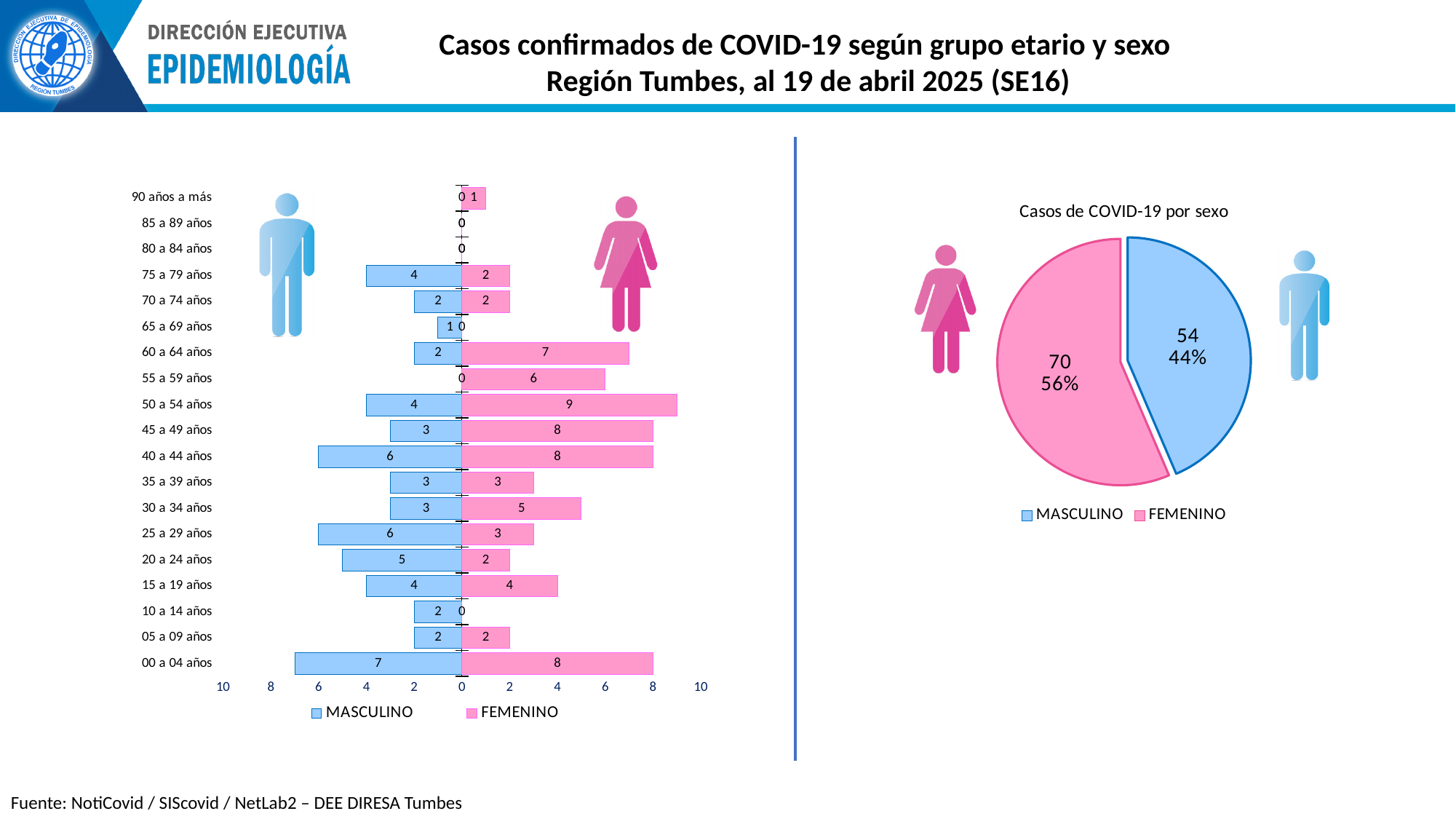
In the 'Casos de COVID-19 por sexo' pie chart, what percentage share does FEMENINO have? 56% In the left chart (age pyramid), which is larger in the 25 a 29 años group, MASCULINO or FEMENINO? MASCULINO In the left chart (age pyramid), how many series does the legend list? 2 In the left chart (age pyramid), what is the difference between FEMENINO and MASCULINO cases in the 60 a 64 años group? 5 In the left chart (age pyramid), which age group has the highest number of MASCULINO cases? 00 a 04 años What type of chart is the 'Casos de COVID-19 por sexo' chart on the right? Pie chart In the left chart (age pyramid), how many age groups are shown on the vertical axis? 19 In the left chart (age pyramid), which age group has the highest number of FEMENINO cases? 50 a 54 años In the left chart (age pyramid), how many FEMENINO cases are in the 50 a 54 años group? 9 In the 'Casos de COVID-19 por sexo' pie chart, what is the total number of cases across both slices? 124 In the left chart (age pyramid), how many FEMENINO cases are in the 60 a 64 años group? 7 In the left chart (age pyramid), how many MASCULINO cases are in the 00 a 04 años group? 7